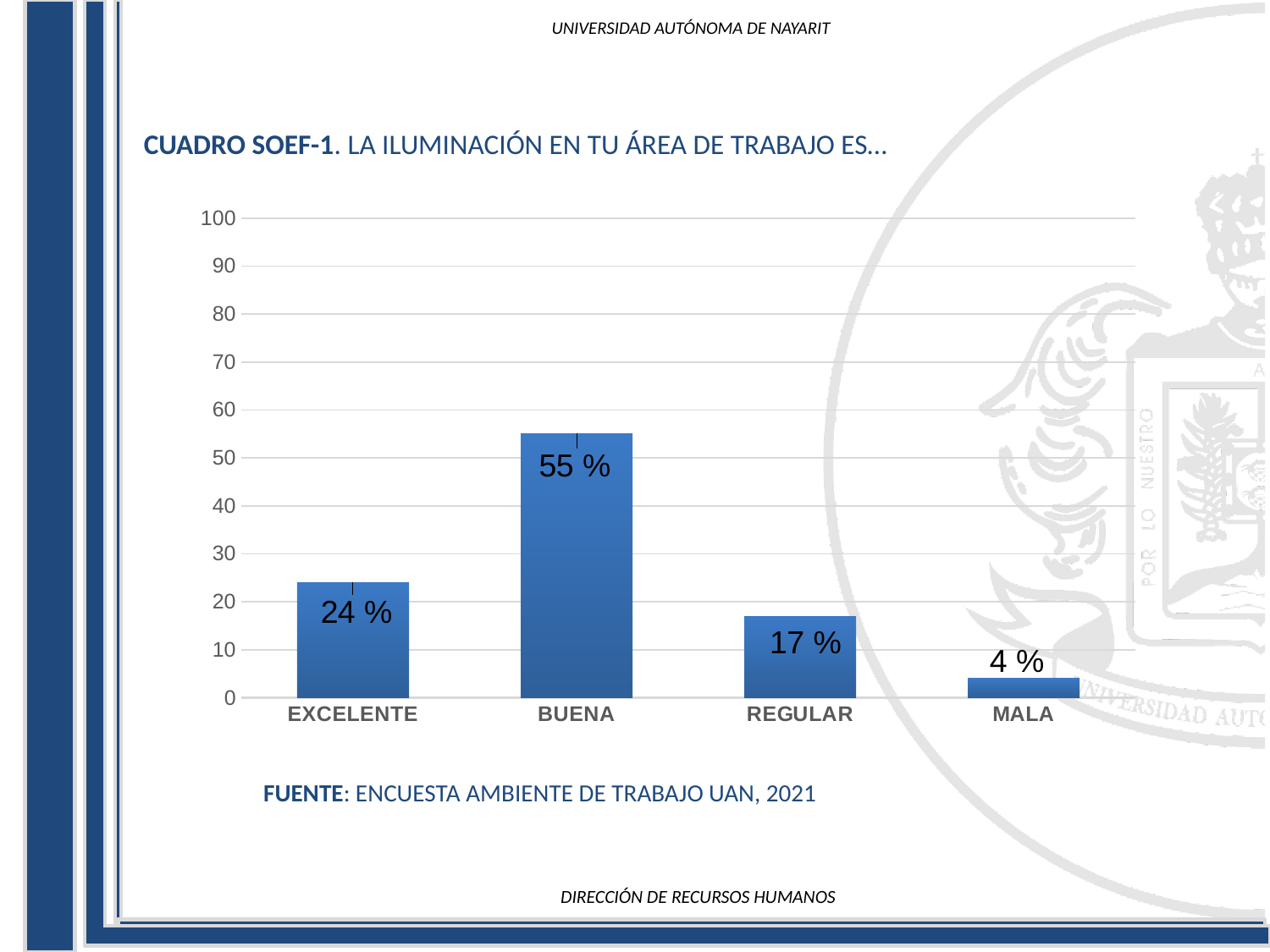
What kind of chart is shown on the slide? bar chart Which category has the highest value? BUENA Which is larger, the value for EXCELENTE or the value for REGULAR? EXCELENTE What is the source cited below the chart? ENCUESTA AMBIENTE DE TRABAJO UAN, 2021 Which category has the lowest value? MALA What is the value for EXCELENTE? 24 % What is the value for BUENA? 55 % Is the value for BUENA greater or less than 50? greater What is the difference between the values for BUENA and EXCELENTE? 31 % What is the value for REGULAR? 17 % How many categories are shown on the x axis? 4 What is the value for MALA? 4 %